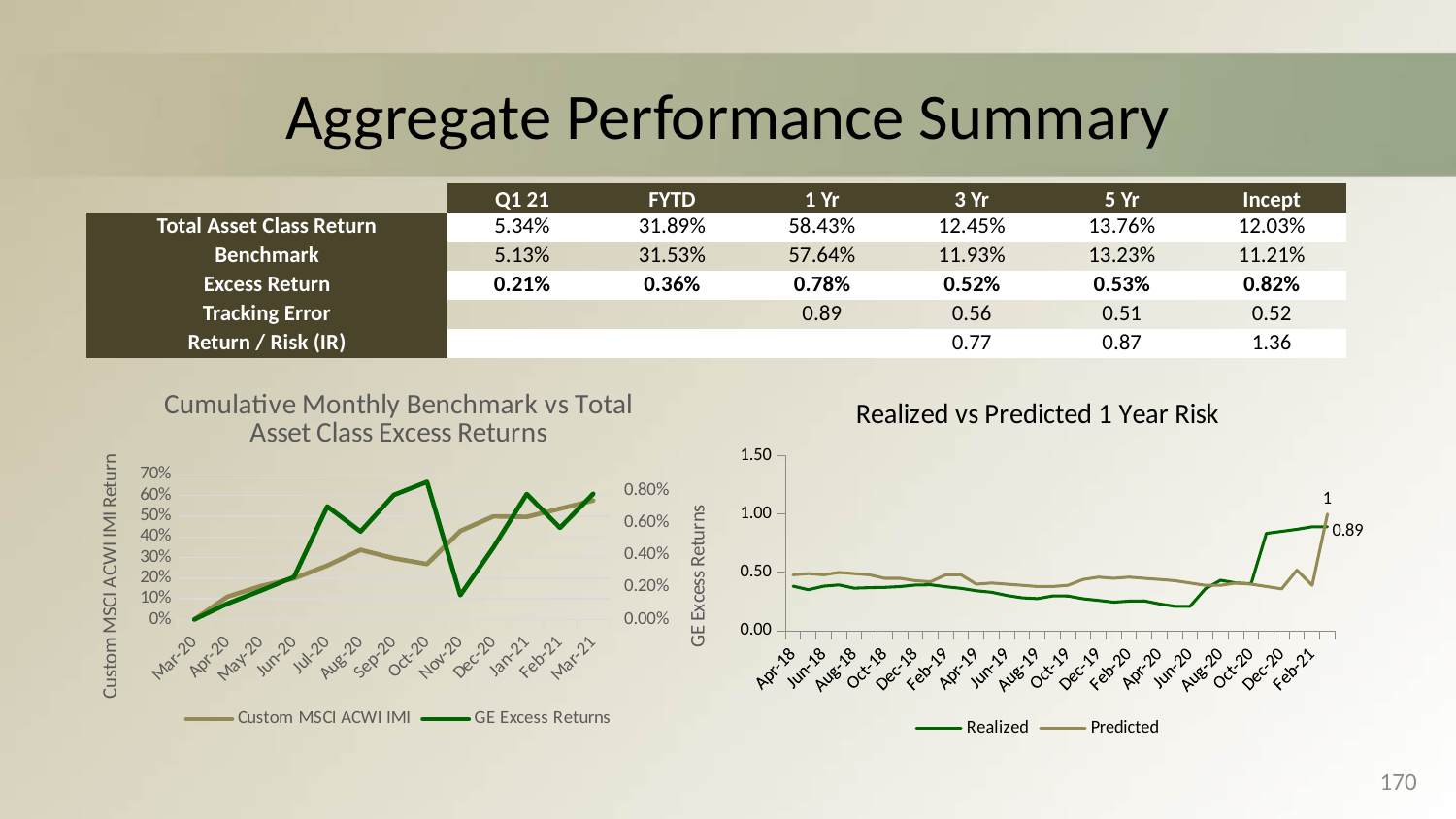
How many series does the legend of the 'Cumulative Monthly Benchmark vs Total Asset Class Excess Returns' chart list? 2 What kind of chart is the 'Realized vs Predicted 1 Year Risk' chart? line chart In the 'Realized vs Predicted 1 Year Risk' chart, is the Realized value at Dec-20 greater or less than 0.50? greater In the 'Cumulative Monthly Benchmark vs Total Asset Class Excess Returns' chart, does the Custom MSCI ACWI IMI series generally rise or fall from Mar-20 to Mar-21? rise How many series does the legend of the 'Realized vs Predicted 1 Year Risk' chart list? 2 In the 'Cumulative Monthly Benchmark vs Total Asset Class Excess Returns' chart, is the Custom MSCI ACWI IMI value at Mar-21 greater or less than 50%? greater In the 'Realized vs Predicted 1 Year Risk' chart, what is the labelled final value of the Predicted series? 1 In the 'Realized vs Predicted 1 Year Risk' chart, is the Realized value at Jun-20 greater or less than 0.50? less In the 'Realized vs Predicted 1 Year Risk' chart, what is the difference between the labelled final values of Realized and Predicted? 0.11 In the 'Realized vs Predicted 1 Year Risk' chart, what is the labelled final value of the Realized series? 0.89 In the 'Realized vs Predicted 1 Year Risk' chart, which series has the larger labelled final value, Realized or Predicted? Predicted How many months are shown on the x axis of the 'Cumulative Monthly Benchmark vs Total Asset Class Excess Returns' chart? 13